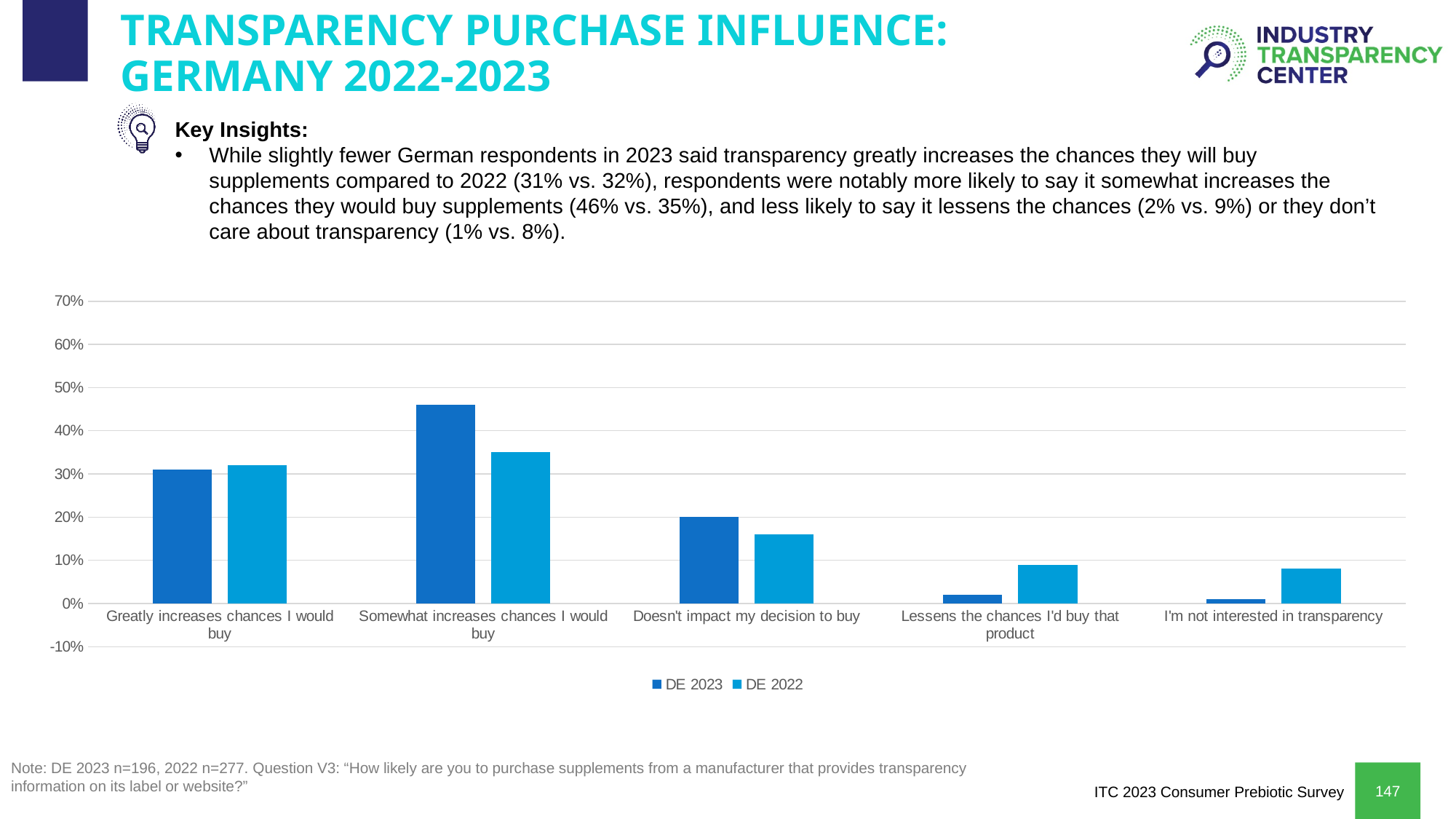
According to the slide, what share of German respondents in 2023 said transparency somewhat increases the chances they would buy supplements? 46% For 'Lessens the chances I'd buy that product', which series has the larger bar, DE 2023 or DE 2022? DE 2022 According to the slide, what is the difference in percentage points between the DE 2023 and DE 2022 values for 'Somewhat increases chances I would buy'? 11 percentage points How many response categories are shown along the x axis of the chart? 5 Which category has the lowest DE 2023 bar? I'm not interested in transparency For 'Somewhat increases chances I would buy', which series has the larger bar, DE 2023 or DE 2022? DE 2023 Which category has the highest DE 2023 bar? Somewhat increases chances I would buy Is the DE 2023 value for 'Doesn't impact my decision to buy' greater or less than 10%? greater What are the two entries in the chart legend? DE 2023 and DE 2022 What kind of chart is shown on the slide? Bar chart How many series does the chart legend list? 2 Is the DE 2022 value for 'Doesn't impact my decision to buy' greater or less than 20%? less